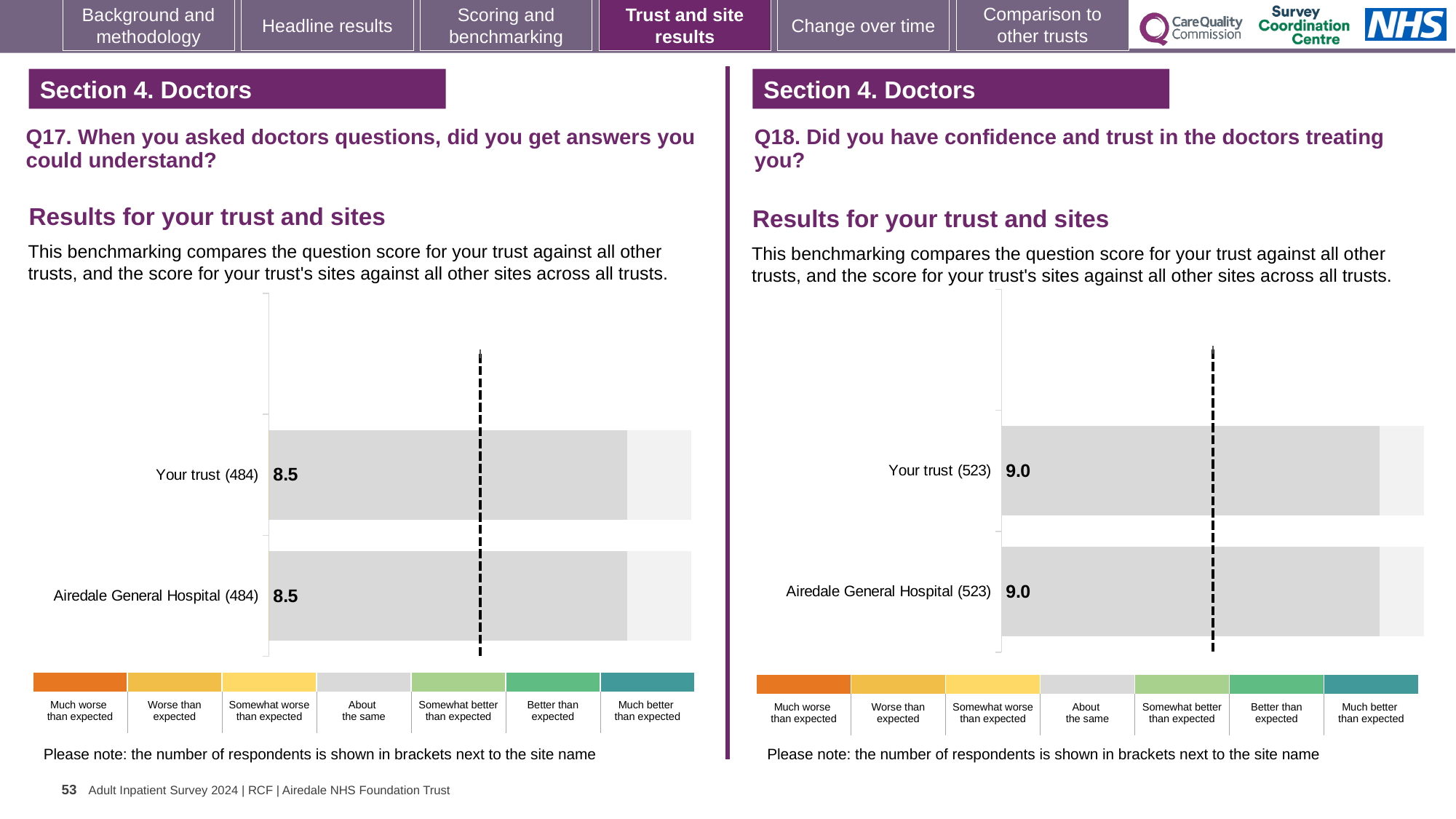
On the Q17 chart (left), what is the score for Your trust? 8.5 On the Q18 chart (right), what is the score for Your trust? 9.0 On the Q18 chart (right), how many respondents are shown in brackets next to Airedale General Hospital? 523 On the Q17 chart (left), what is the score for Airedale General Hospital? 8.5 On the Q18 chart (right), what is the score for Airedale General Hospital? 9.0 How many bars are plotted on the Q18 chart (right)? 2 On the Q17 chart (left), what is the difference between the score for Your trust and the score for Airedale General Hospital? 0.0 What kind of chart is used for the Q18 results (right)? Bar chart On the Q18 chart (right), what is the difference between the score for Your trust and the score for Airedale General Hospital? 0.0 How many bars are plotted on the Q17 chart (left)? 2 How many rating categories does the colour key below the Q17 chart (left) list? 7 On the Q17 chart (left), how many respondents are shown in brackets next to Your trust? 484